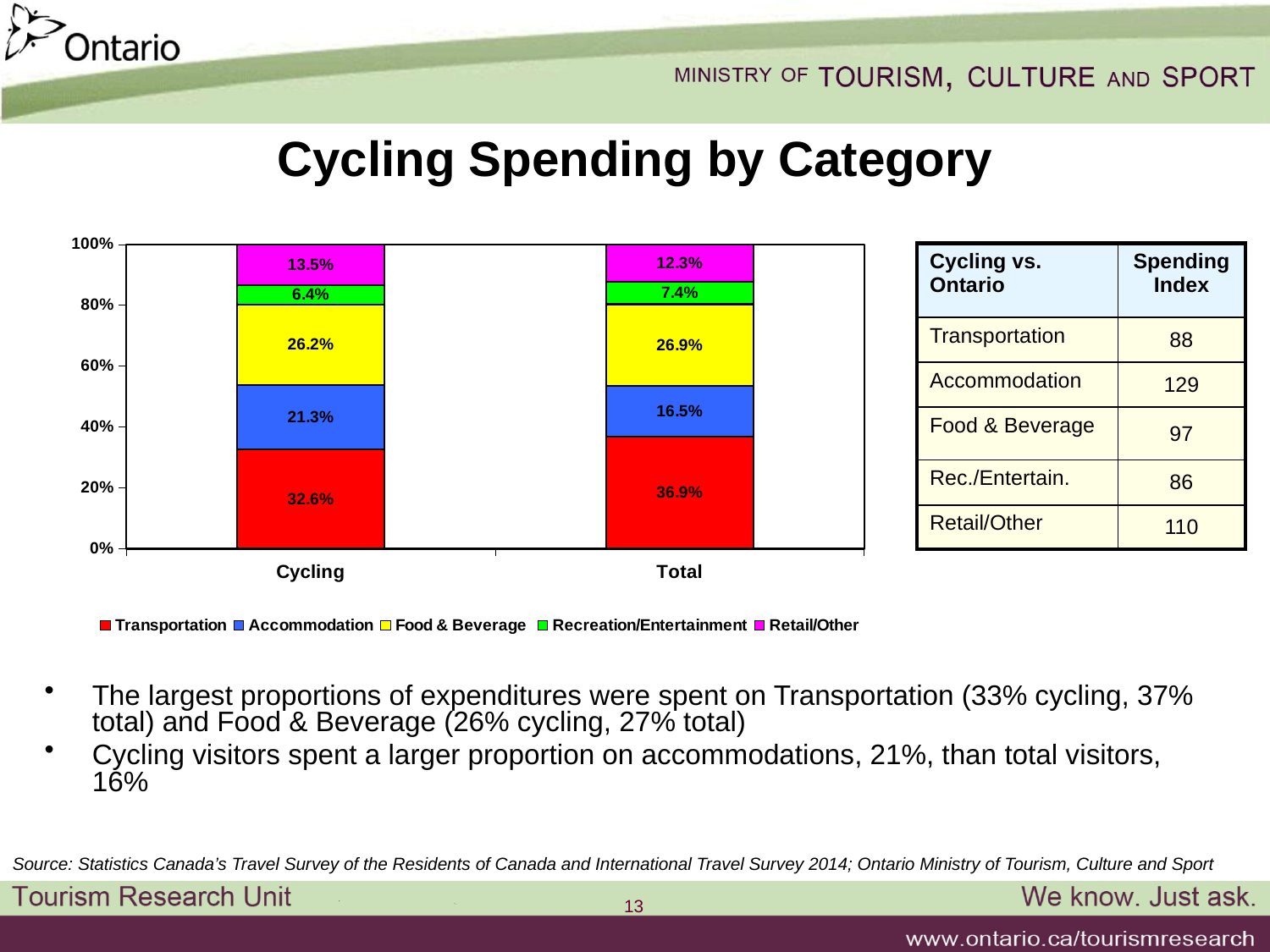
How many series does the legend list? 5 What is the Accommodation value for the Total bar? 16.5% What is the Recreation/Entertainment value for the Total bar? 7.4% What is the Retail/Other value for the Cycling bar? 13.5% Which colour represents Food & Beverage in the chart? Yellow Which category has the smallest share in the Total bar? Recreation/Entertainment What is the difference between the Accommodation share for Cycling and for Total? 4.8 percentage points Which is larger, the Transportation share for Cycling or for Total? Total What share of cycling spending went to Transportation? 32.6% Which category has the largest share in the Cycling bar? Transportation How many bars are shown on the x axis? 2 What kind of chart is shown? Stacked bar chart